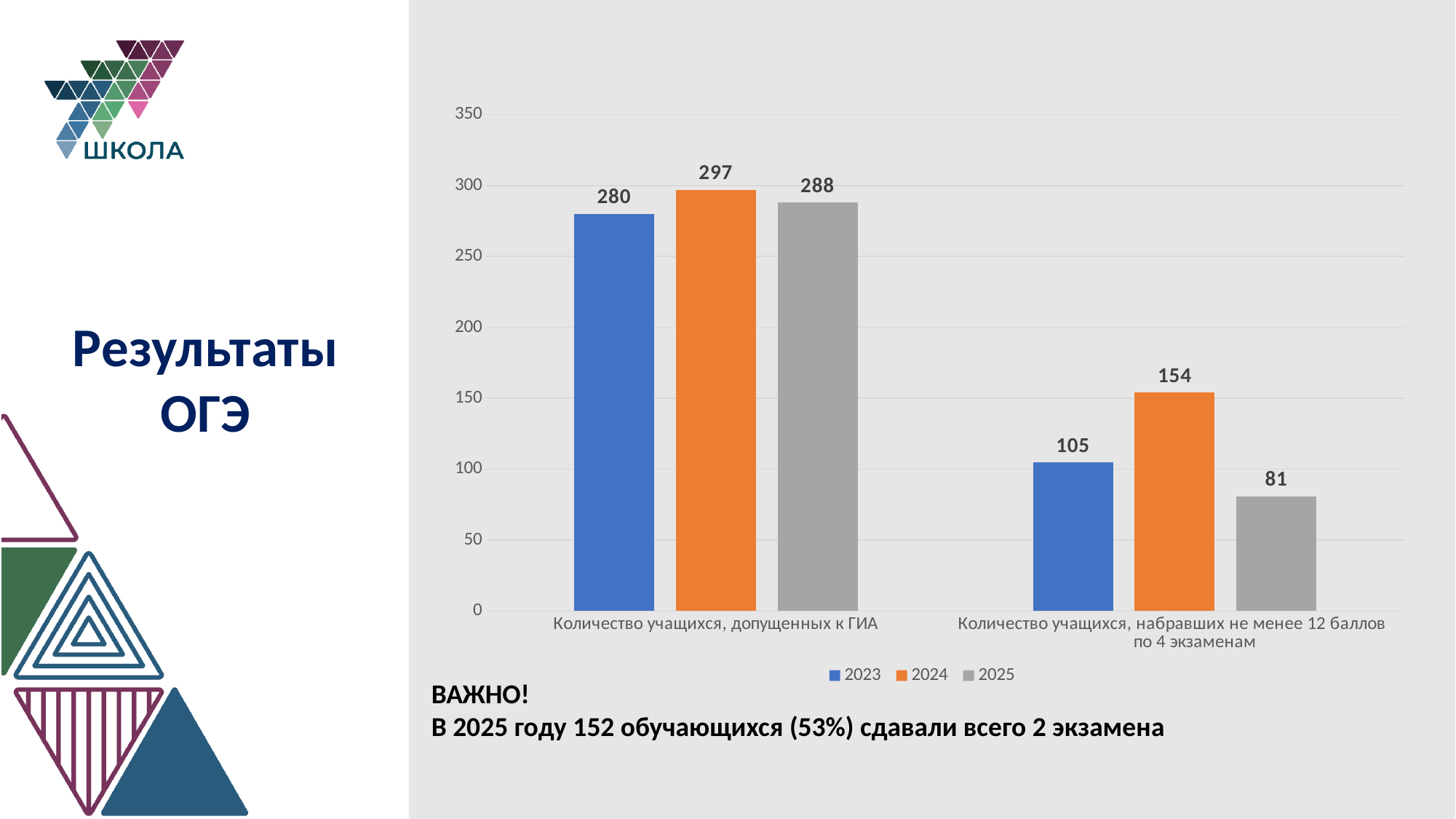
How many series does the legend list? 3 What is the value for 2025 in the category "Количество учащихся, допущенных к ГИА"? 288 What is the difference between the 2024 and 2023 values in the category "Количество учащихся, допущенных к ГИА"? 17 What is the value for 2023 in the category "Количество учащихся, допущенных к ГИА"? 280 Is the 2025 value in the category "Количество учащихся, набравших не менее 12 баллов по 4 экзаменам" greater or less than 100? less Which is larger: the 2023 value or the 2025 value in the category "Количество учащихся, набравших не менее 12 баллов по 4 экзаменам"? 2023 Which year has the highest value in the category "Количество учащихся, допущенных к ГИА"? 2024 How many categories are shown on the x axis? 2 What kind of chart is shown on the slide? bar chart What is the difference between the 2024 and 2025 values in the category "Количество учащихся, набравших не менее 12 баллов по 4 экзаменам"? 73 What is the value for 2024 in the category "Количество учащихся, набравших не менее 12 баллов по 4 экзаменам"? 154 Which year has the lowest value in the category "Количество учащихся, набравших не менее 12 баллов по 4 экзаменам"? 2025